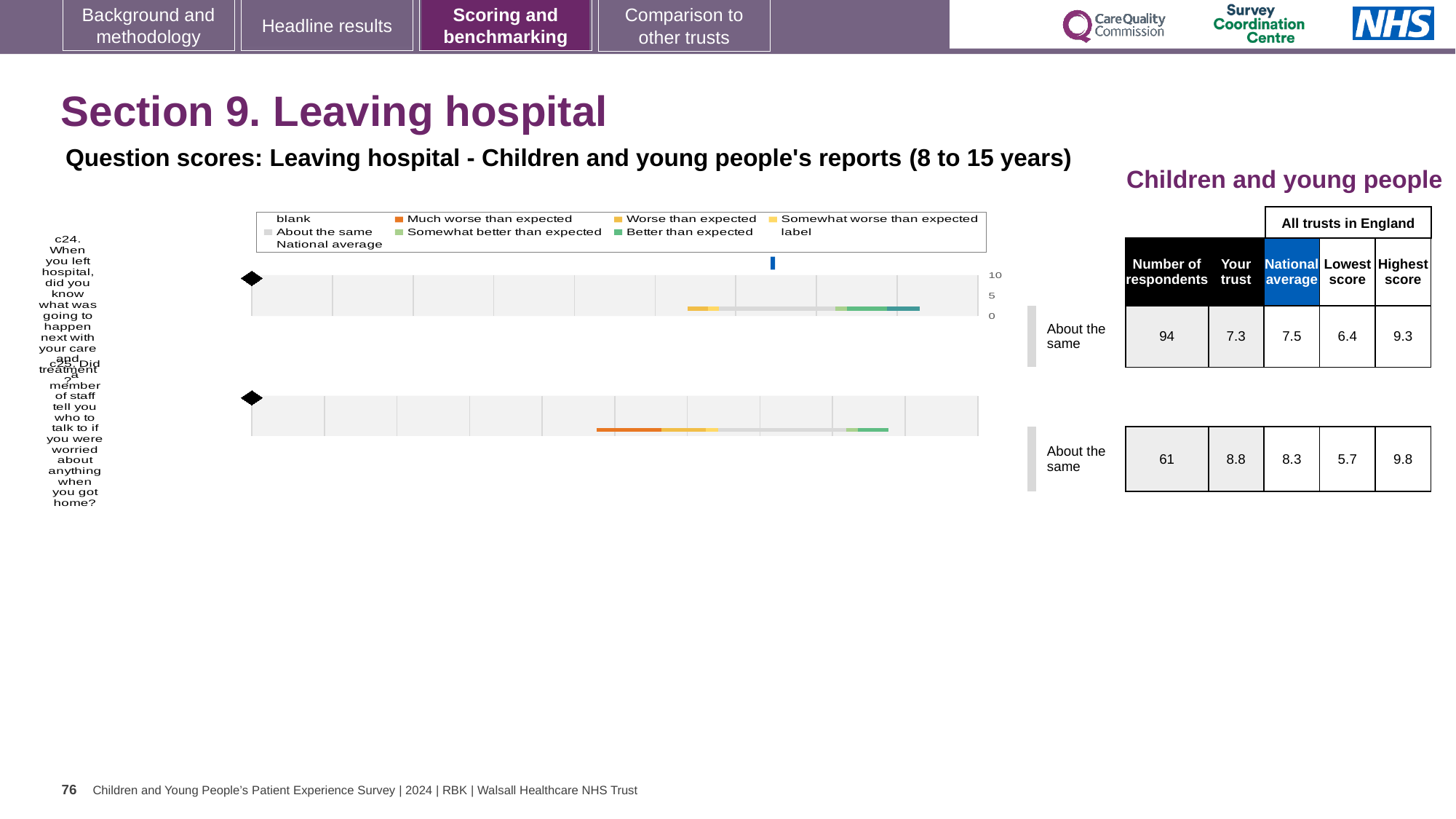
What is the highest score among all trusts in England for question c25? 9.8 What kind of chart is used to show the question scores for Leaving hospital? Bar chart By how much does the trust's score for c25 exceed the national average for c25? 0.5 Which question had more respondents, c24 or c25? c24 What colour represents 'Much worse than expected' in the chart legend? Orange What is the national average score for question c25 (did a member of staff tell you who to talk to if you were worried)? 8.3 How many survey questions (bars) are plotted in the Leaving hospital chart? 2 What benchmark category is shown for question c24? About the same Which question has the higher 'Your trust' score, c24 or c25? c25 What is the 'Your trust' score for question c24 (did you know what was going to happen next with your care and treatment)? 7.3 What is the difference between the highest and lowest trust scores for question c24? 2.9 How many respondents answered question c24? 94